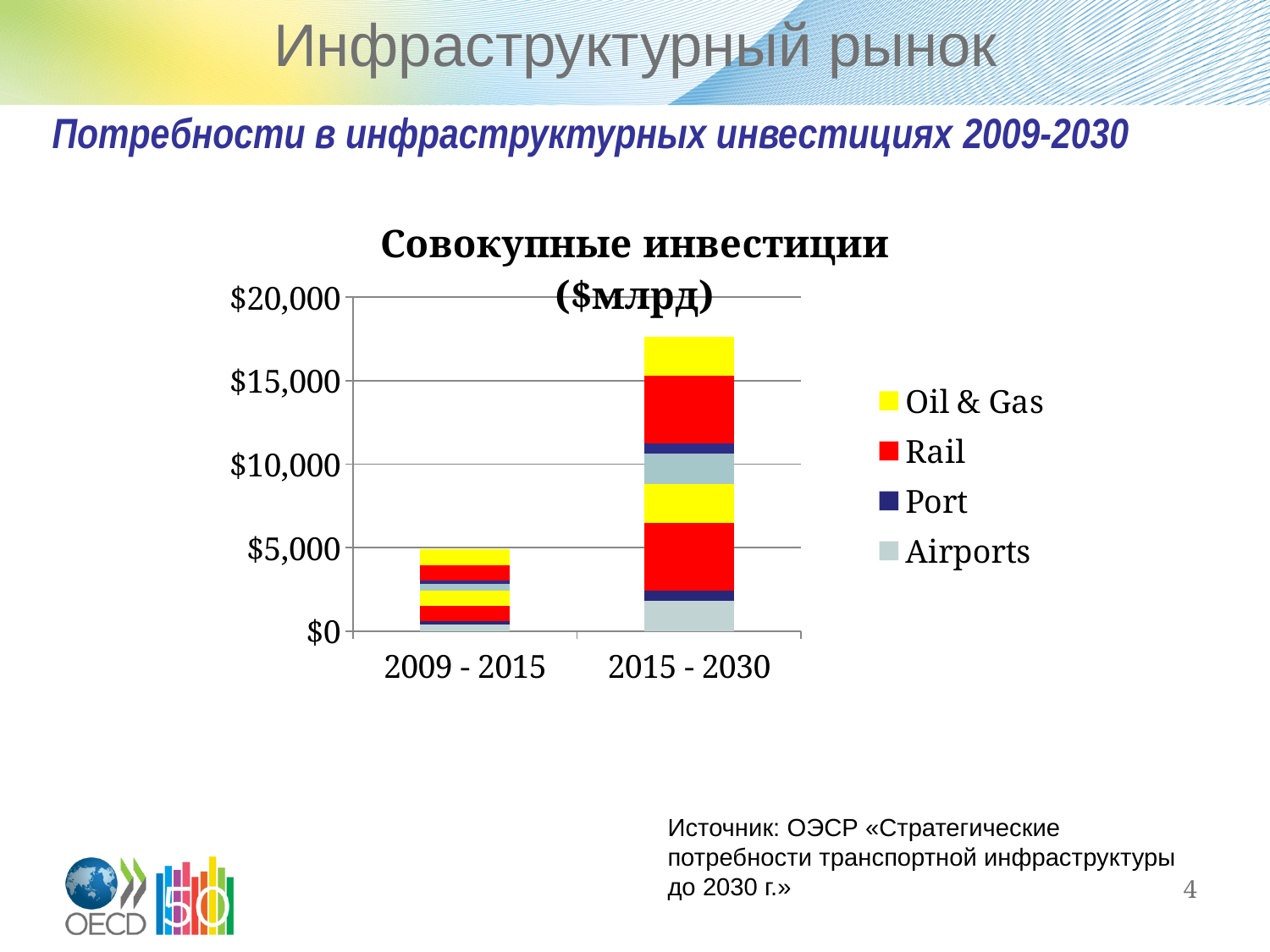
Is the total of the stacked bar for 2015 - 2030 greater or less than $15,000? greater How many series does the chart's legend list? 4 Which period has the taller stacked bar, 2009 - 2015 or 2015 - 2030? 2015 - 2030 What is the title of the chart? Совокупные инвестиции ($млрд) Is the total of the stacked bar for 2015 - 2030 greater or less than $20,000? less Which series is shown in yellow in the chart's legend? Oil & Gas Which of the two bars is larger, the one for 2009 - 2015 or the one for 2015 - 2030? 2015 - 2030 Which period has the shorter stacked bar? 2009 - 2015 What kind of chart is shown on the slide? stacked bar chart Do the total investment values rise or fall from 2009 - 2015 to 2015 - 2030? rise How many time periods (categories) are shown on the x axis of the chart? 2